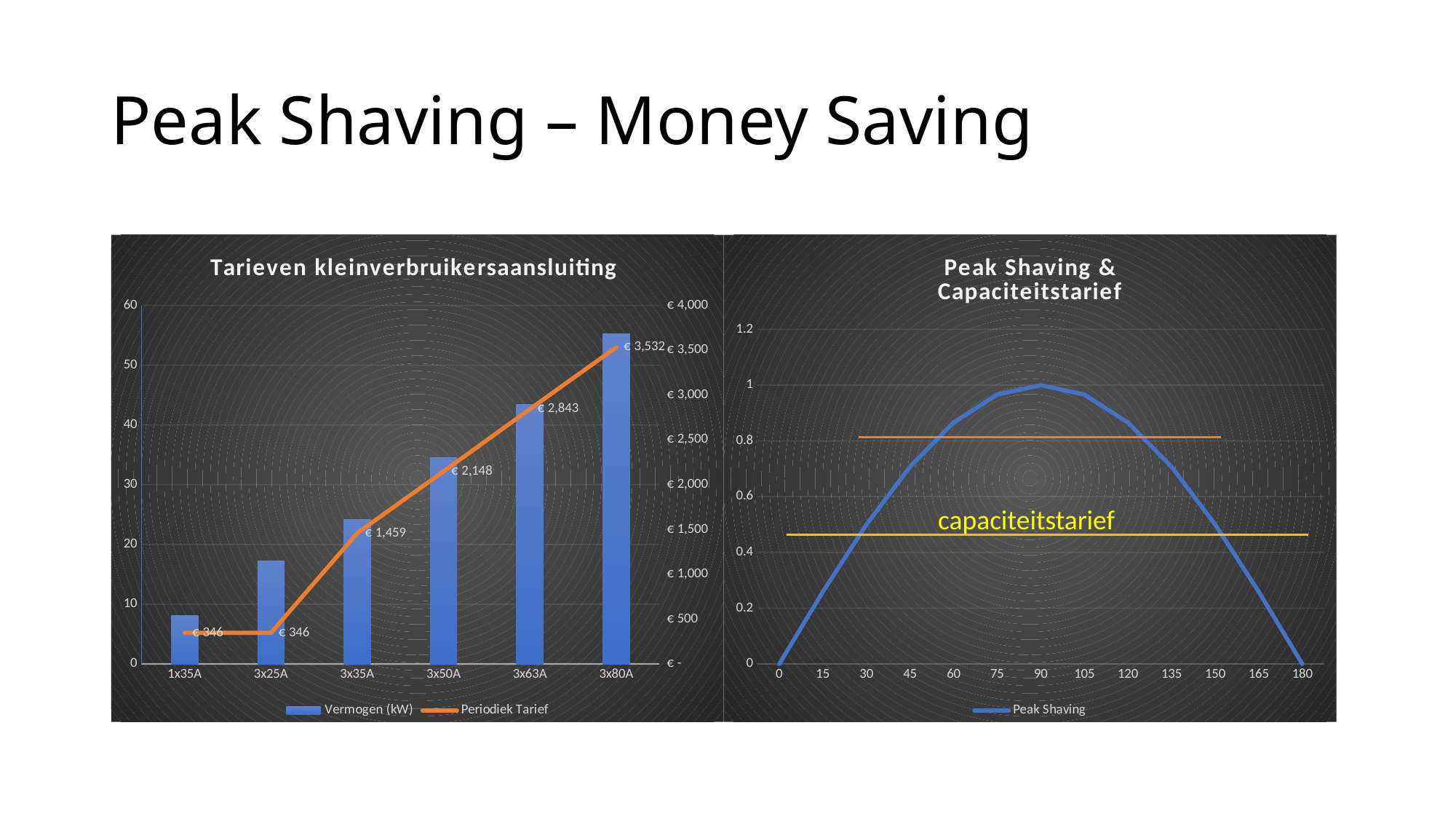
In the chart titled 'Tarieven kleinverbruikersaansluiting', which has the larger Periodiek Tarief, 3x35A or 3x25A? 3x35A In the chart titled 'Tarieven kleinverbruikersaansluiting', how many connection types are shown on the x axis? 6 In the chart titled 'Tarieven kleinverbruikersaansluiting', does the Periodiek Tarief rise or fall from 3x25A to 3x80A? rises In the chart titled 'Tarieven kleinverbruikersaansluiting', which connection type has the highest Periodiek Tarief? 3x80A In the chart titled 'Peak Shaving & Capaciteitstarief', is the Peak Shaving value at x = 90 greater or less than 0.8? greater In the chart titled 'Tarieven kleinverbruikersaansluiting', is the Vermogen (kW) value for 1x35A greater or less than 10? less In the chart titled 'Tarieven kleinverbruikersaansluiting', how many series does the legend list? 2 In the chart titled 'Tarieven kleinverbruikersaansluiting', is the Vermogen (kW) value for 3x50A greater or less than 30? greater What kind of chart is the chart titled 'Peak Shaving & Capaciteitstarief' on the right? line chart In the chart titled 'Tarieven kleinverbruikersaansluiting', what is the difference in Periodiek Tarief between 3x80A and 3x63A? € 689 In the chart titled 'Tarieven kleinverbruikersaansluiting', what is the Periodiek Tarief for 3x80A? € 3,532 In the chart titled 'Tarieven kleinverbruikersaansluiting', what is the Periodiek Tarief for 3x50A? € 2,148